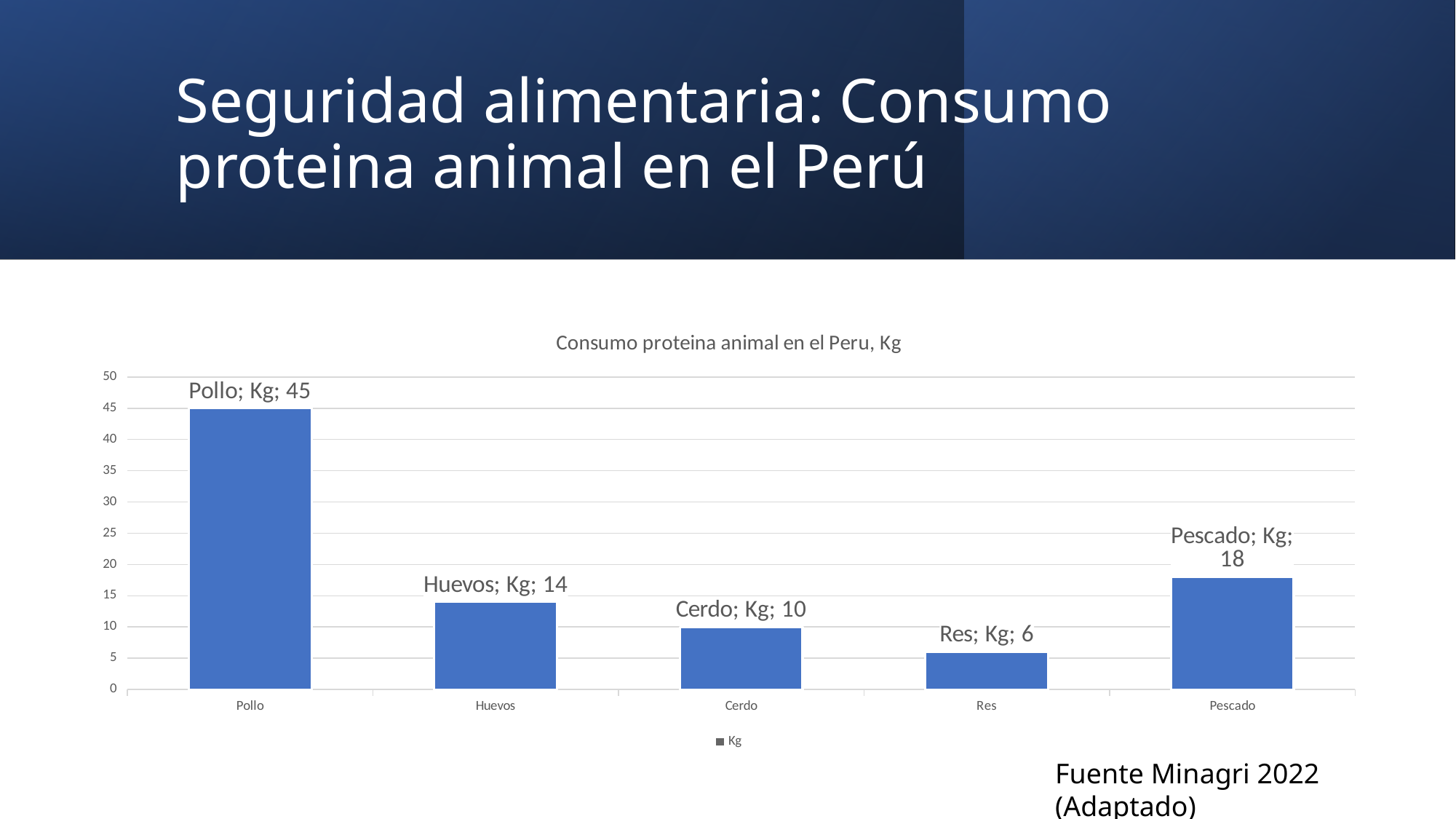
How many categories are shown on the x axis? 5 Is the value for Cerdo greater or less than 15? less What is the value for Pescado? 18 What is the title of the chart? Consumo proteina animal en el Peru, Kg What is the difference between the values for Cerdo and Res? 4 What is the value for Huevos? 14 Which category has the highest value? Pollo What kind of chart is shown? bar chart Which is larger, the value for Huevos or the value for Pescado? Pescado Which category has the lowest value? Res What is the difference between the values for Pollo and Pescado? 27 What is the value for Pollo? 45